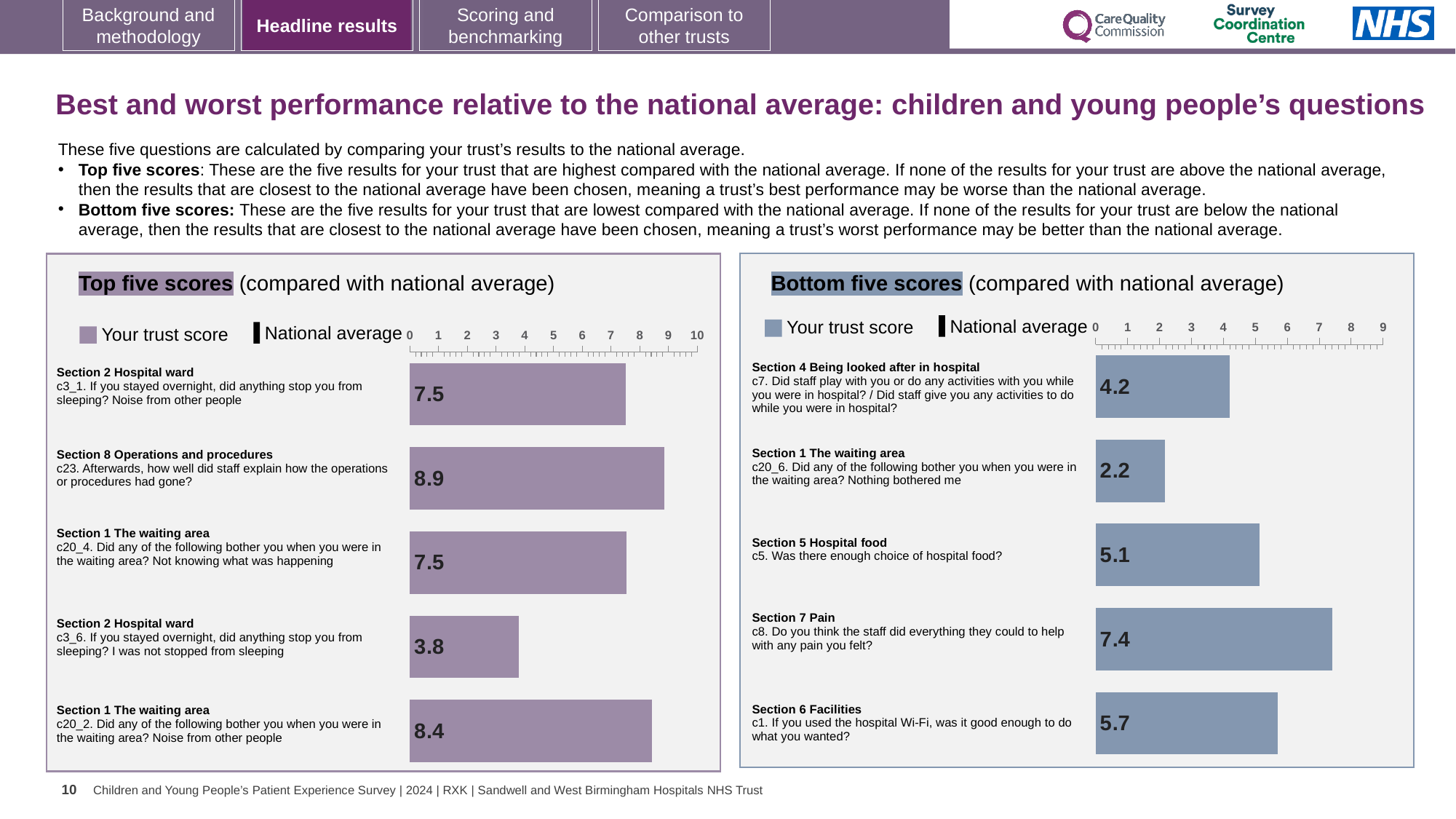
In the Top five scores chart, what is the difference between the trust scores for c23 and c3_6? 5.1 In the Bottom five scores chart, what is the trust score for c20_6 (Nothing bothered me in the waiting area)? 2.2 In the Bottom five scores chart, which question has the highest trust score? c8. Do you think the staff did everything they could to help with any pain you felt? In the Bottom five scores chart, which question has the lowest trust score? c20_6. Did any of the following bother you when you were in the waiting area? Nothing bothered me What type of chart is the Top five scores chart? Bar chart In the Top five scores chart, which question has the highest trust score? c23. Afterwards, how well did staff explain how the operations or procedures had gone? In the Bottom five scores chart, what is the trust score for c1 (hospital Wi-Fi)? 5.7 In the Top five scores chart, what is the trust score for c23 (how well did staff explain how the operations or procedures had gone)? 8.9 How many questions are shown in the Bottom five scores chart? 5 In the Top five scores chart, what is the trust score for c3_6 (I was not stopped from sleeping)? 3.8 How many series does the legend of the Top five scores chart list? 2 In the Bottom five scores chart, which is larger: the trust score for c5 (hospital food) or for c7 (staff play with you)? c5 (hospital food)